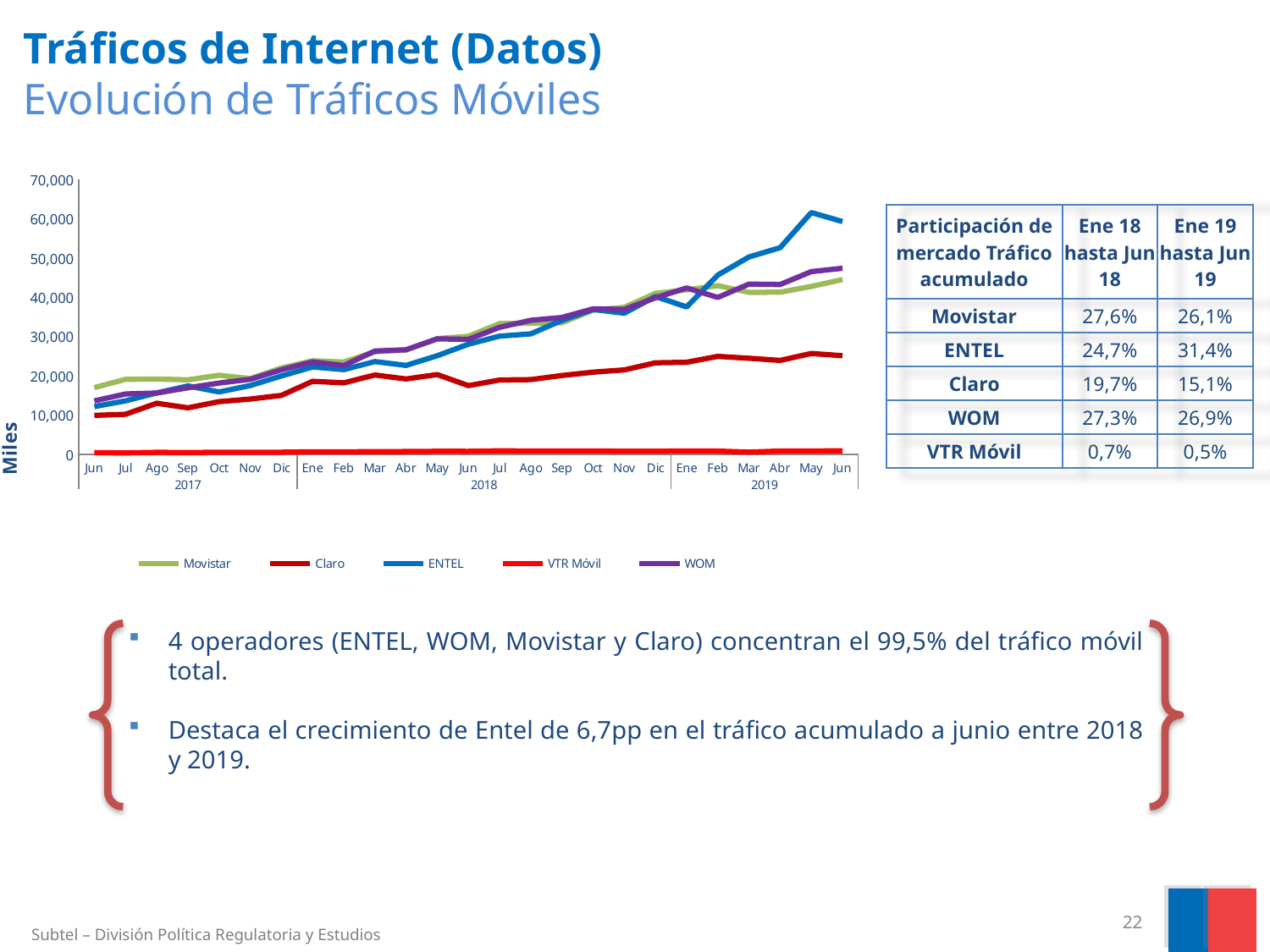
Is the value for WOM in Jun 2019 greater or less than 40,000? greater What kind of chart is shown on the slide? Line chart What is the label on the vertical axis of the chart? Miles In Jun 2019, which is larger, the value for ENTEL or the value for Claro? ENTEL Is the value for Claro in Jun 2019 greater or less than 30,000? less Does the ENTEL series rise or fall from Jun 2017 to Jun 2019? Rises How many series does the chart legend list? 5 Which series has the highest value in Jun 2019? ENTEL How many monthly points are plotted along the x axis of the chart? 25 Is the value for ENTEL in Jun 2019 greater or less than 50,000? greater Which series is drawn in green in the chart legend? Movistar Which series has the lowest values across the whole chart? VTR Móvil